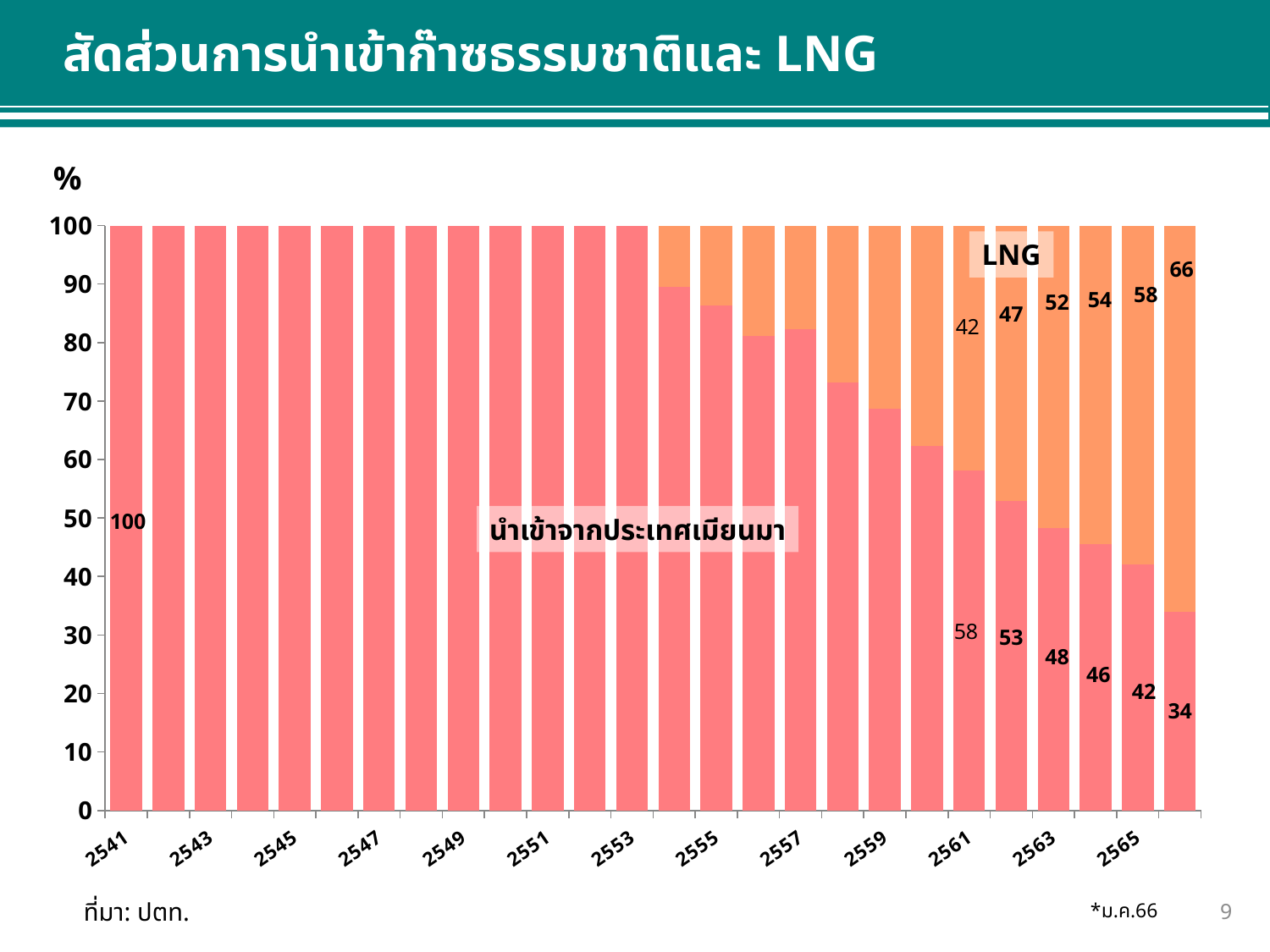
In 2563, which is larger: the LNG share or the share imported from Myanmar? LNG How many series are stacked in each bar of the chart? 2 What is the share imported from Myanmar (นำเข้าจากประเทศเมียนมา) in 2565? 42 What is the LNG share in 2565? 58 What is the LNG share in the rightmost bar of the chart? 66 What is the share imported from Myanmar in 2541? 100 What kind of chart is shown on the slide? bar chart In 2565, how much larger is the LNG share than the share imported from Myanmar? 16 From 2554 onward, does the share imported from Myanmar rise or fall over the years? fall What is the share imported from Myanmar in 2563? 48 Is the share imported from Myanmar in 2557 greater or less than 90? less What is the LNG share in 2561? 42